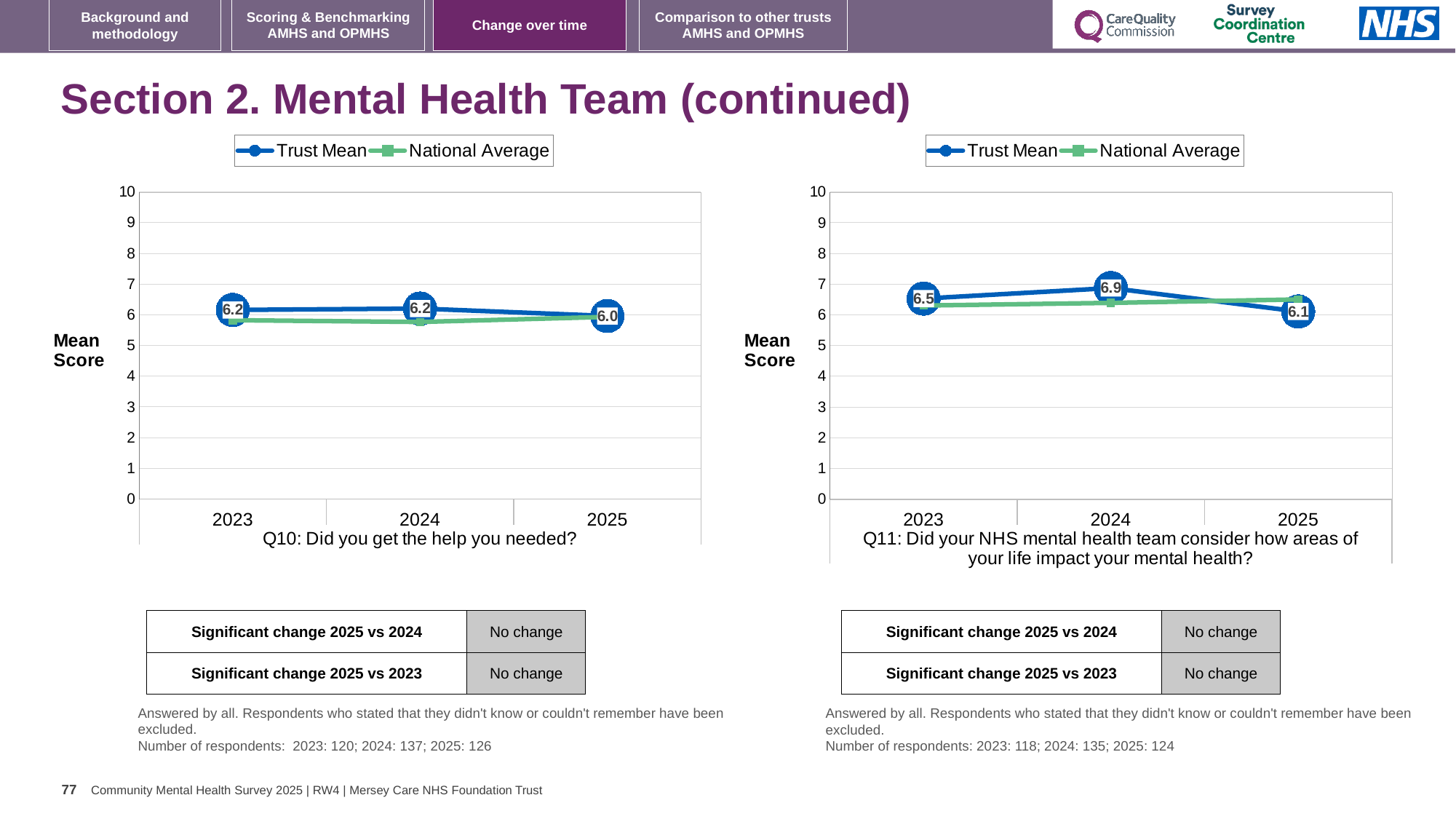
In the Q10 chart, what is the Trust Mean for 2023? 6.2 What kind of chart is the Q10 chart? Line chart In the Q11 chart, what is the Trust Mean for 2025? 6.1 In the Q10 chart, is the Trust Mean for 2024 greater or less than 5? greater In the Q10 chart, how many years are plotted on the x axis? 3 In the Q11 chart, which year has the highest Trust Mean? 2024 How many series does the legend of the Q11 chart list? 2 In the Q10 chart, what is the Trust Mean for 2025? 6.0 In the Q11 chart, which year has the lowest Trust Mean? 2025 In the Q11 chart, what is the difference between the Trust Mean for 2024 and 2025? 0.8 In the Q11 chart, what is the Trust Mean for 2024? 6.9 In the Q11 chart, does the Trust Mean rise or fall from 2024 to 2025? Fall